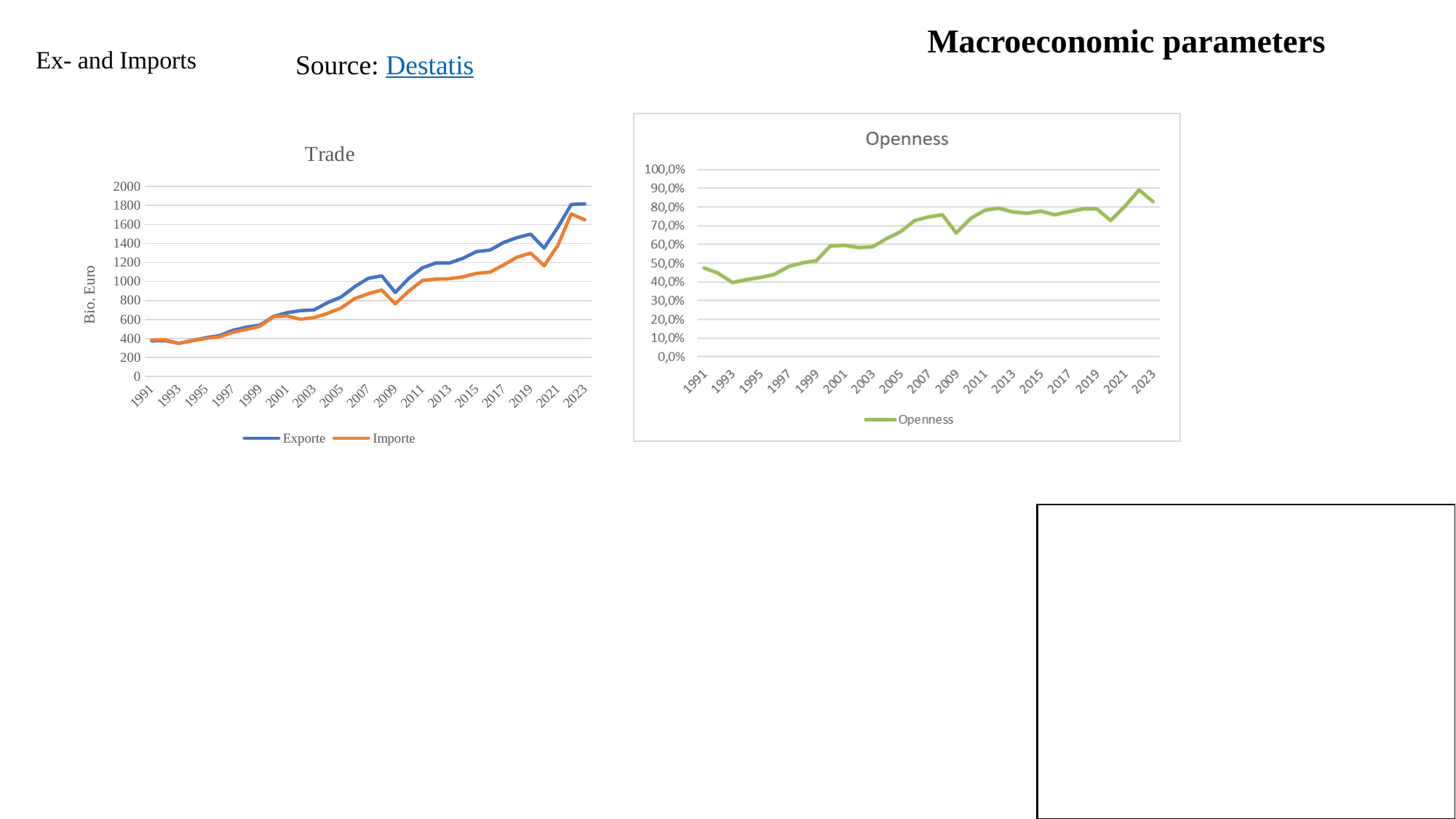
In the Trade chart, do the values for Exporte generally rise or fall from 1991 to 2023? rise In the Openness chart, do the values generally rise or fall from 1991 to 2023? rise In the Openness chart, is the value for 2009 greater or less than 70,0%? less In the Trade chart, is the value for Exporte in 2009 greater or less than 1000? less What is the y-axis label of the Trade chart? Bio. Euro In the Openness chart, is the value for 1993 greater or less than 50,0%? less What kind of chart is the Trade chart? line chart In the Openness chart, which year has the lowest value? 1993 How many series does the legend of the Trade chart list? 2 In the Trade chart, which series has the larger value in 2023, Exporte or Importe? Exporte